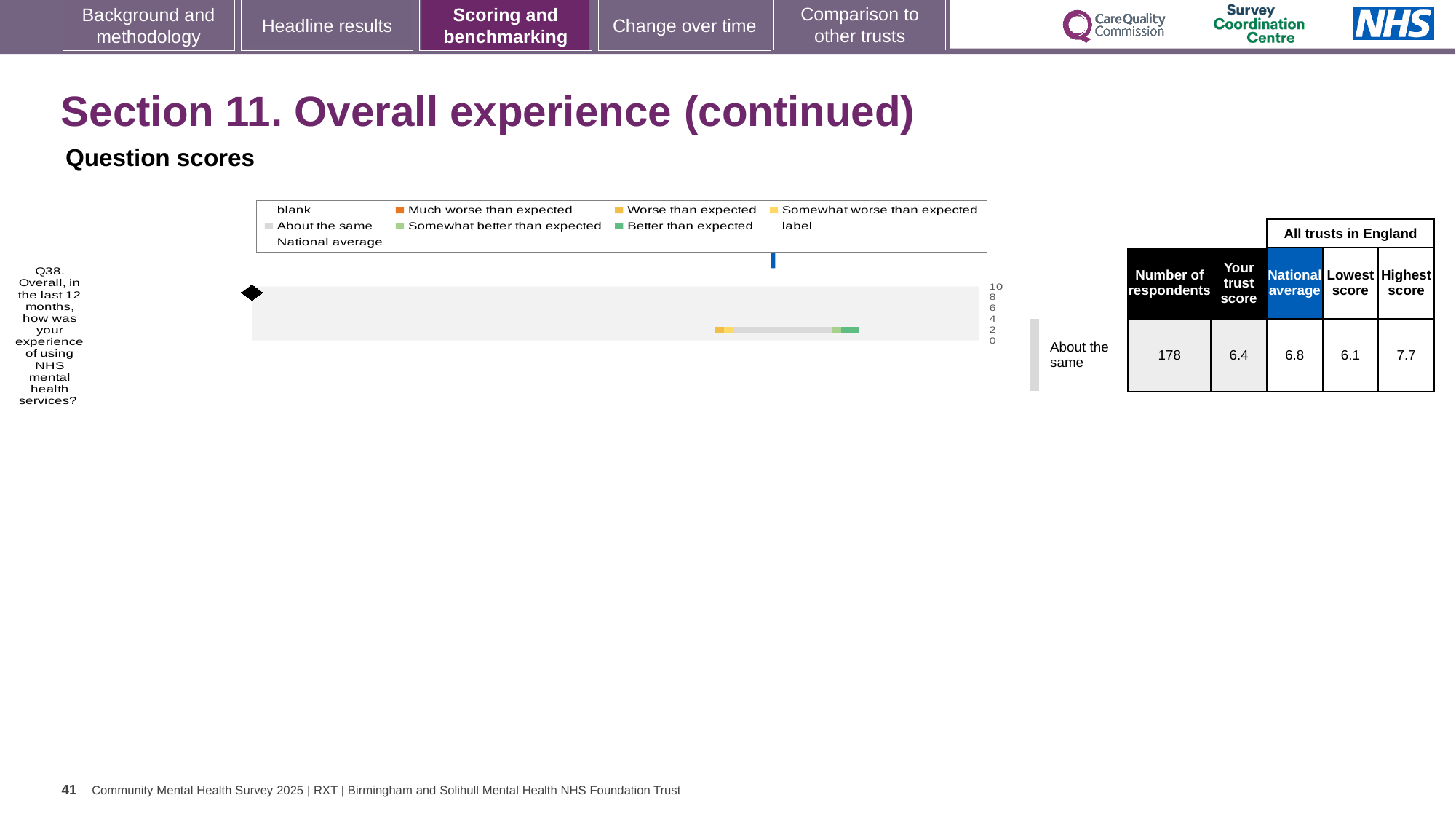
How many questions (categories) are plotted in the chart? 1 What is the difference between the national average and the trust's score for Q38? 0.4 What kind of chart is shown on the slide? bar chart What is the national average score for Q38? 6.8 What benchmark category is the trust's Q38 score placed in? About the same What is the lowest score among all trusts in England for Q38? 6.1 What is the maximum value shown on the chart's score axis? 10 Which is larger for Q38: the trust's score or the national average? national average Which question is plotted in the chart? Q38. Overall, in the last 12 months, how was your experience of using NHS mental health services? How many respondents answered Q38? 178 What is the highest score among all trusts in England for Q38? 7.7 What is the trust's score for Q38 according to the table next to the chart? 6.4